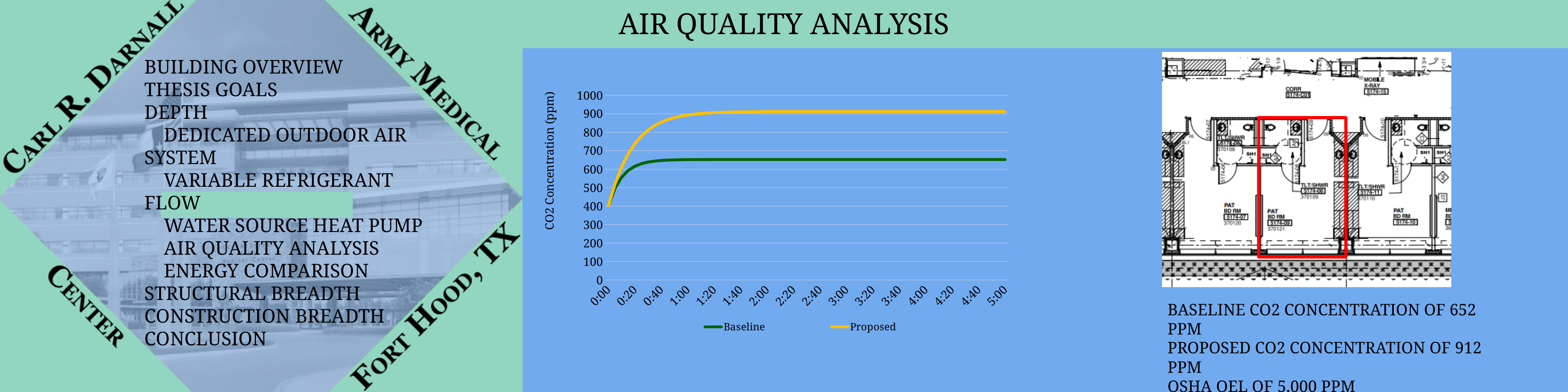
Is the value of the Baseline series at 5:00 greater or less than 700? less What is the label of the y axis? CO2 Concentration (ppm) What is the highest value shown on the y axis? 1000 Which two series are listed in the legend? Baseline and Proposed What kind of chart is shown on the slide? line chart How many time points are labelled on the x axis? 16 Is the value of the Proposed series at 5:00 greater or less than 900? greater Is the value of the Baseline series at 5:00 greater or less than 600? greater Which series reaches the higher CO2 concentration, Baseline or Proposed? Proposed How many series does the legend list? 2 At what CO2 concentration do both series start at 0:00? 400 Do the CO2 concentration values rise or fall along the x axis from 0:00 onward? rise